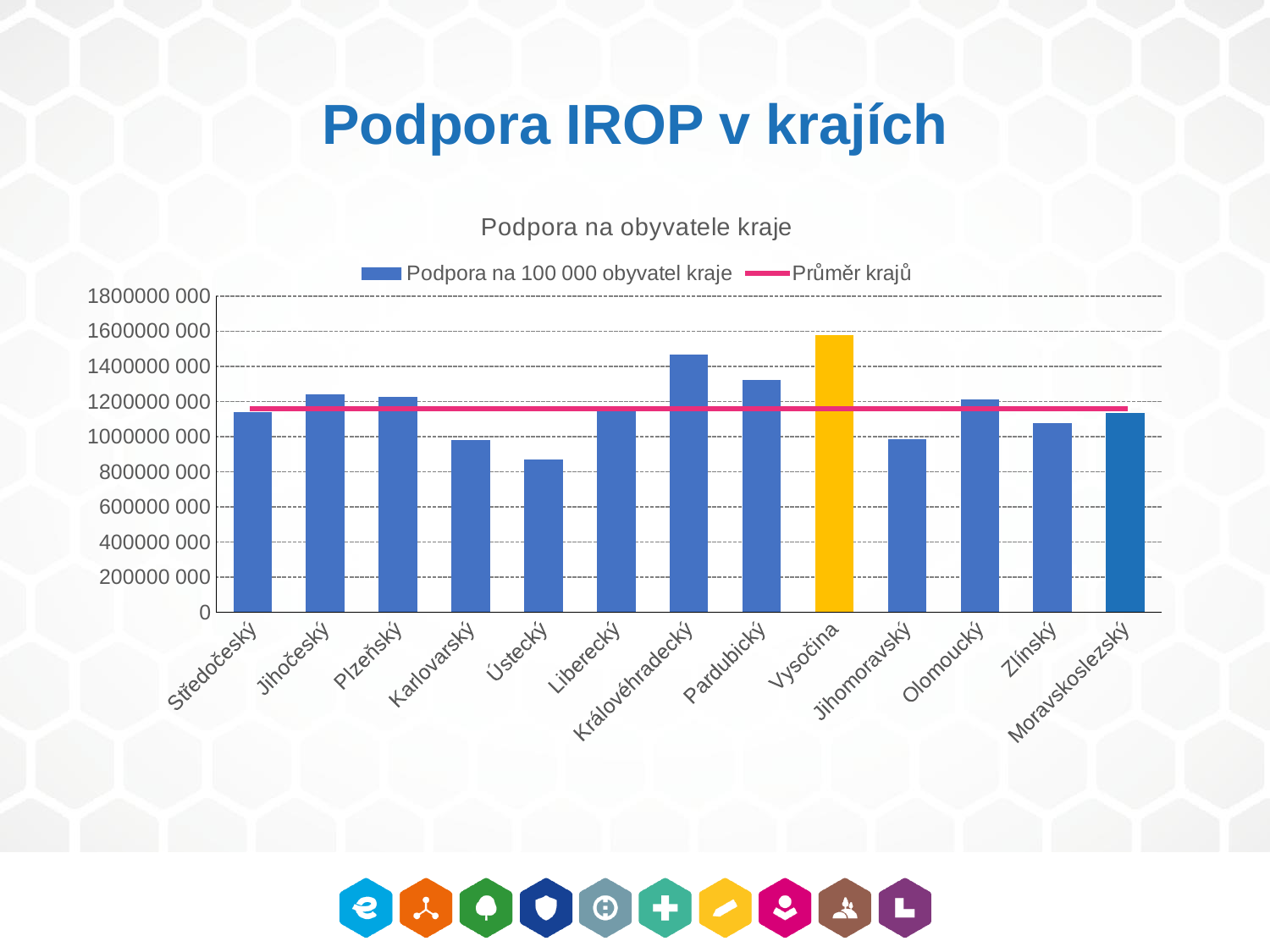
How many regions (categories) are shown on the x axis of the chart? 13 What is the title of the chart? Podpora na obyvatele kraje Which region has the highest value for Podpora na 100 000 obyvatel kraje? Vysočina Is the value for Vysočina greater or less than 1400000 000? greater How many series does the chart legend list? 2 Is the value for Královéhradecký greater or less than 1400000 000? greater Is the value for Ústecký greater or less than 1000000 000? less Which region has the larger value, Karlovarský or Ústecký? Karlovarský Which region has the larger value, Královéhradecký or Pardubický? Královéhradecký What kind of chart is shown on the slide? combination bar and line chart Which region has the lowest value for Podpora na 100 000 obyvatel kraje? Ústecký